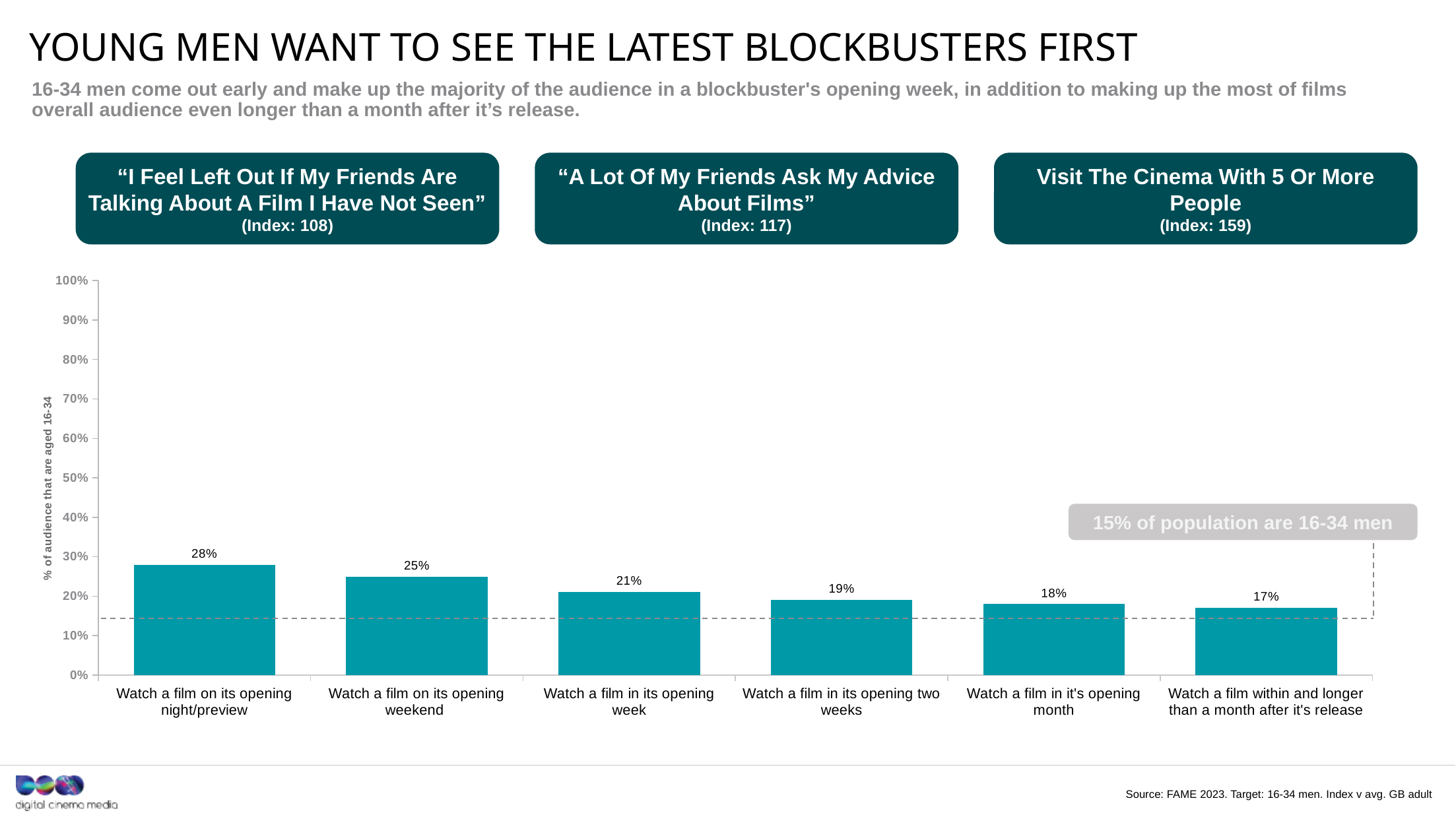
What percentage of the audience that watch a film on its opening night/preview are aged 16-34? 28% How many categories are shown on the x axis of the chart? 6 What is the difference between the values for 'Watch a film on its opening night/preview' and 'Watch a film on its opening weekend'? 3% Which is larger: the value for 'Watch a film in its opening two weeks' or 'Watch a film in it's opening month'? Watch a film in its opening two weeks Which category has the highest value? Watch a film on its opening night/preview Is the value for 'Watch a film on its opening weekend' greater or less than 20%? greater Which category has the lowest value? Watch a film within and longer than a month after it's release Do the values rise or fall from left to right along the x axis? fall What does the dashed horizontal line on the chart represent, according to the label? 15% of population are 16-34 men What is the value for 'Watch a film in its opening week'? 21% What kind of chart is shown on the slide? bar chart What is the value for 'Watch a film within and longer than a month after it's release'? 17%